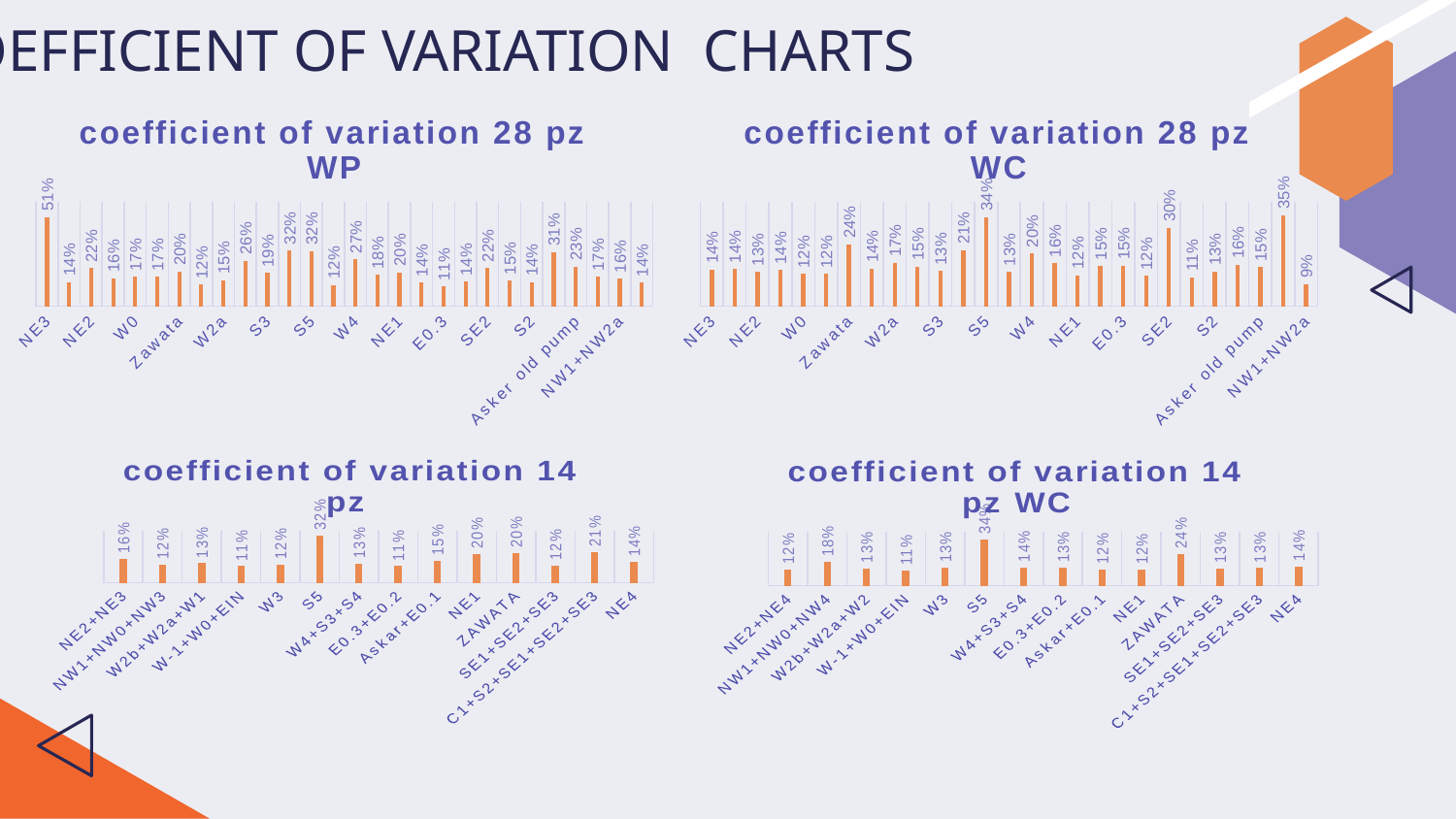
What type of chart is the 'coefficient of variation 28 pz WP' chart? Bar chart In the 'coefficient of variation 28 pz WP' chart, what is the highest value shown? 51% In the 'coefficient of variation 14 pz WC' chart, what is the value for ZAWATA? 24% In the 'coefficient of variation 28 pz WP' chart, which category has the highest coefficient of variation? NE3 In the 'coefficient of variation 14 pz' chart, what is the difference between the values for S5 and NE2+NE3? 16% In the 'coefficient of variation 14 pz' chart, what is the value for NE4? 14% In the 'coefficient of variation 14 pz WC' chart, which is larger, the value for NW1+NW0+NW4 or the value for NE1? NW1+NW0+NW4 In the 'coefficient of variation 28 pz WC' chart, what is the highest value shown? 35% In the 'coefficient of variation 28 pz WC' chart, what is the lowest value shown? 9% In the 'coefficient of variation 14 pz' chart, what is the value for S5? 32% In the 'coefficient of variation 14 pz' chart, how many categories are plotted? 14